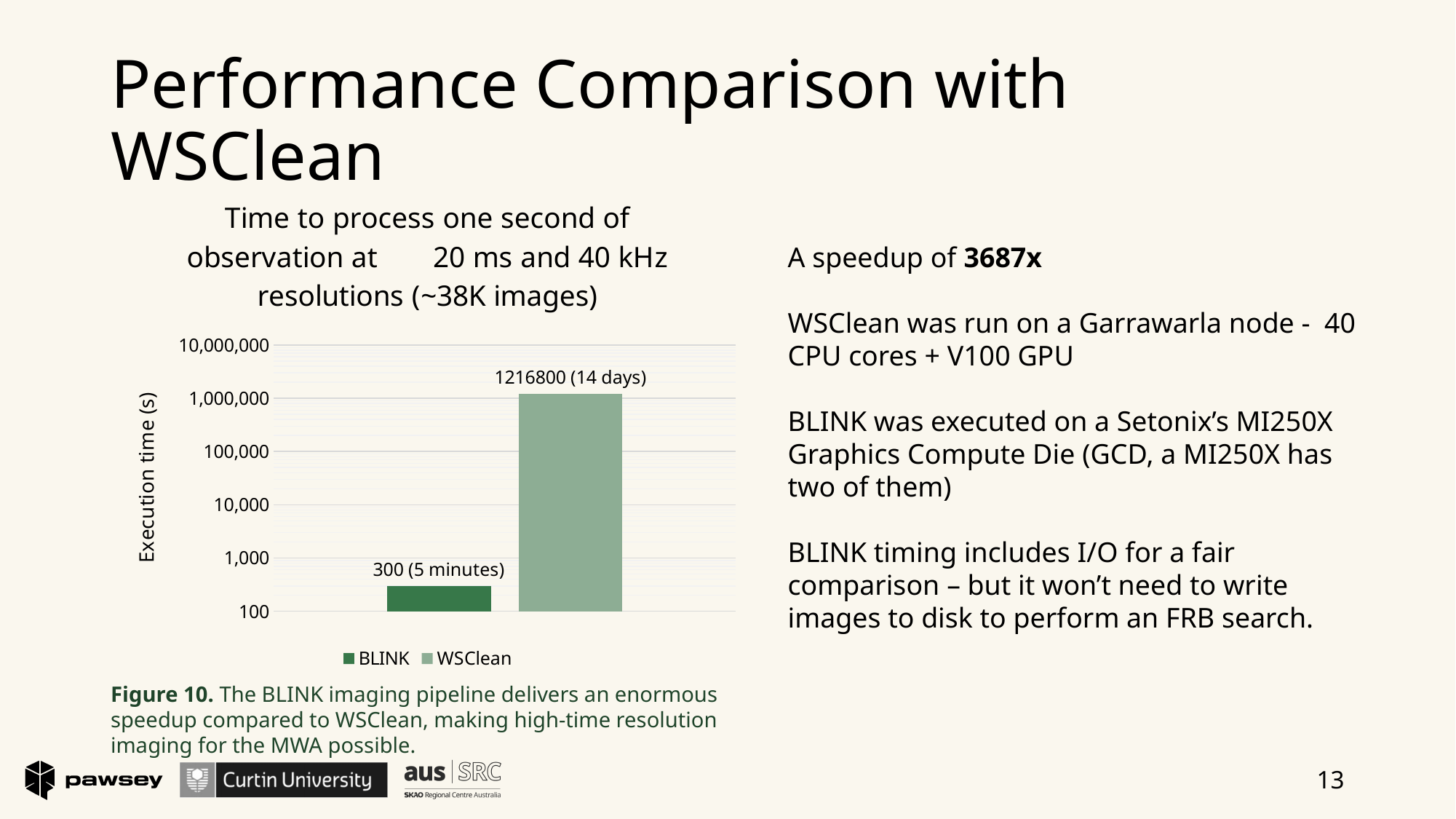
Is the execution time for BLINK greater or less than 1,000 seconds? less Is the execution time for WSClean greater or less than 1,000,000 seconds? greater How many series does the legend list? 2 What kind of chart is shown on the slide? bar chart How many bars are plotted in the chart? 2 What is the label of the vertical axis? Execution time (s) What is the difference in execution time between WSClean and BLINK, in seconds? 1216500 What is the execution time shown for WSClean? 1216800 (14 days) Which series has the lowest execution time? BLINK Which series has the higher execution time, BLINK or WSClean? WSClean What is the highest tick value shown on the vertical axis? 10,000,000 What is the execution time shown for BLINK? 300 (5 minutes)